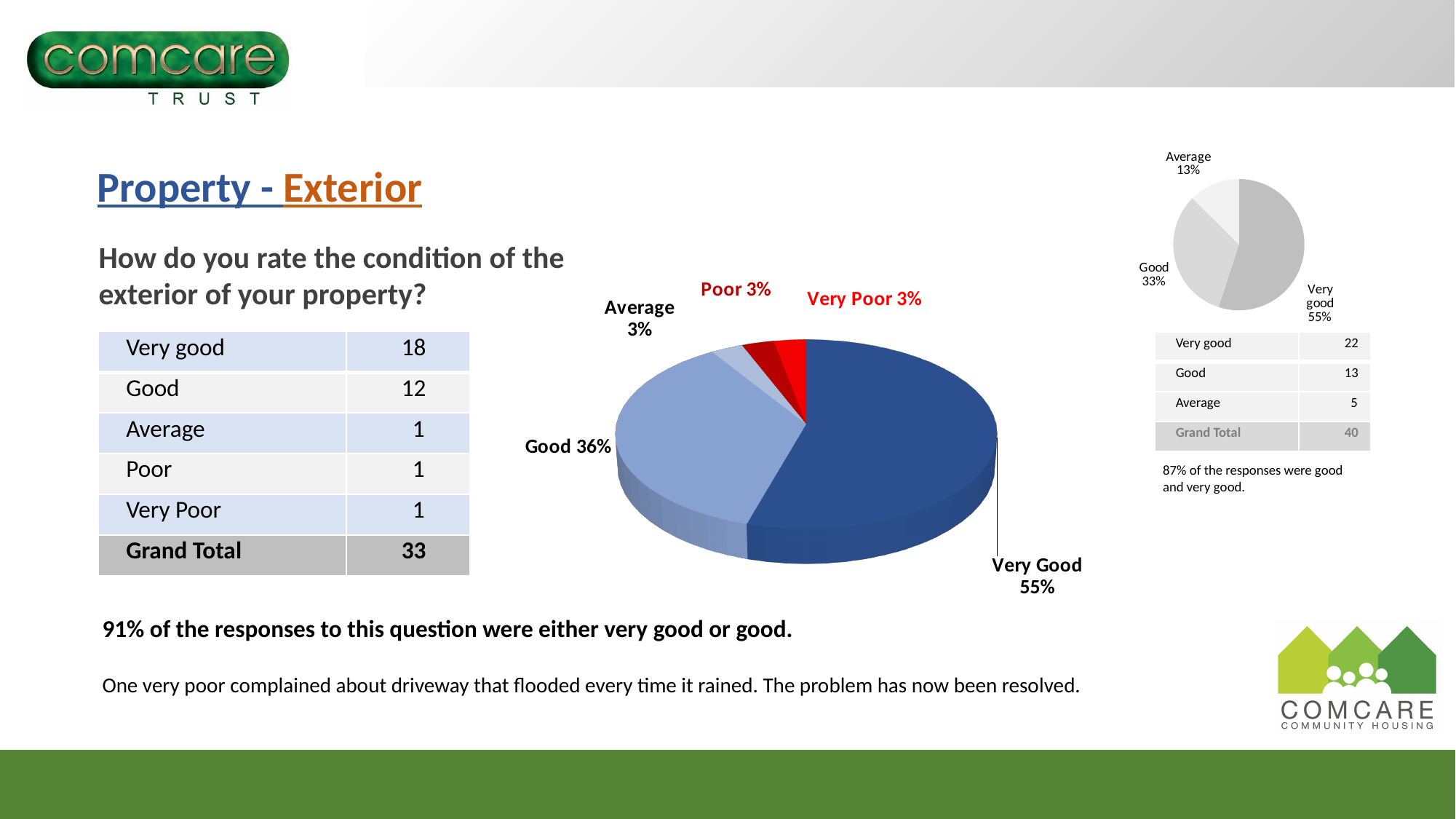
In the small grey pie chart at the top right, what share is labelled for Average? 13% In the large central pie chart, what share is labelled for Good? 36% In the large central pie chart, which is larger, the Good slice or the Very Good slice? Very Good How many slices does the small grey pie chart at the top right have? 3 What type of chart is the large chart in the centre of the slide? pie chart In the large central pie chart, which category has the largest slice? Very Good In the large central pie chart, what is the difference in percentage points between the Very Good and Good slices? 19 How many slices does the large central pie chart have? 5 In the small grey pie chart at the top right, what share is labelled for Good? 33% In the small grey pie chart at the top right, which category has the smallest slice? Average